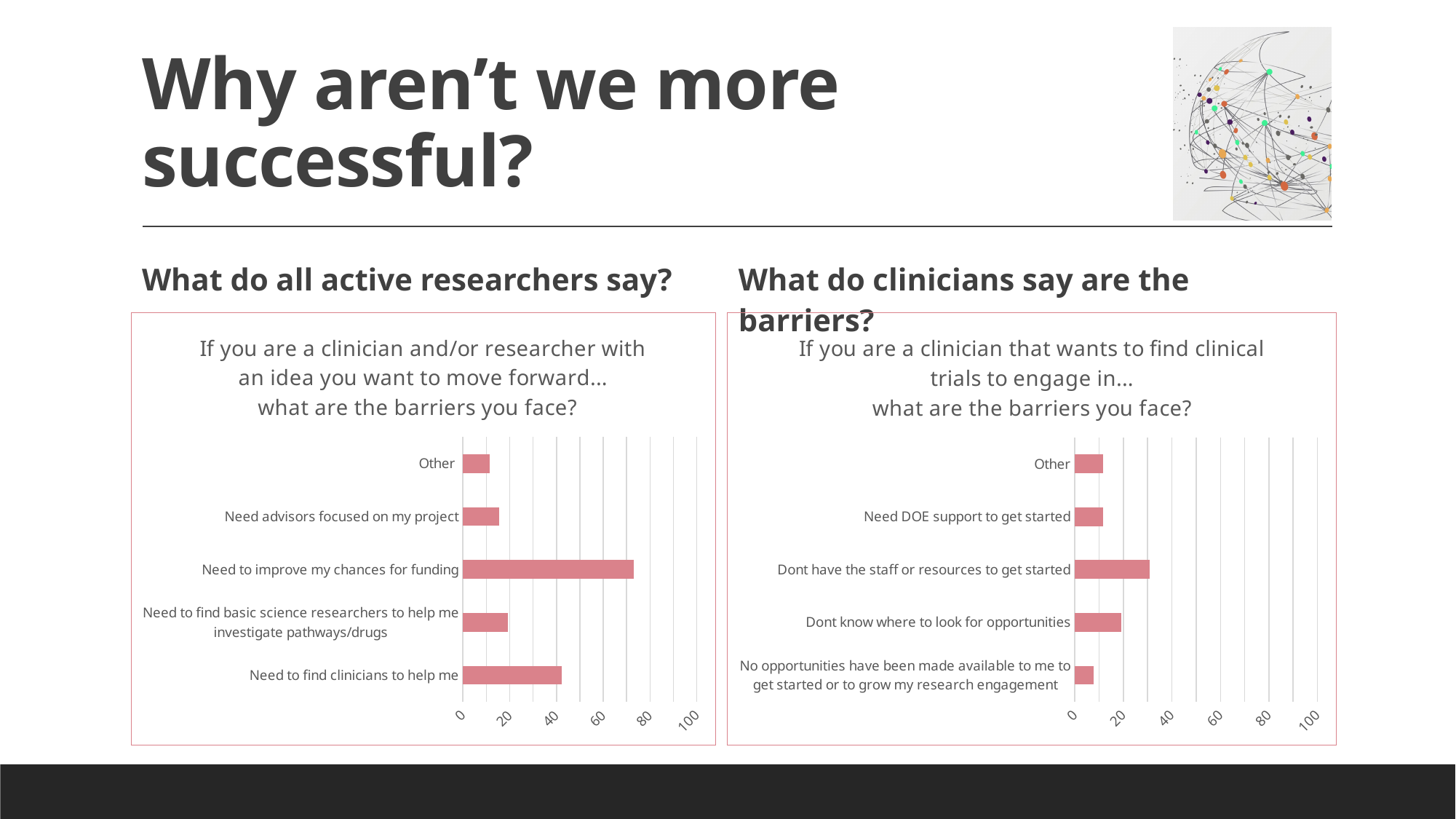
What kind of chart is the left chart, 'If you are a clinician and/or researcher with an idea you want to move forward... what are the barriers you face?'? Bar chart In the right chart (clinician that wants to find clinical trials), which barrier has the highest value? Dont have the staff or resources to get started In the right chart (clinician that wants to find clinical trials), is the value for 'Other' greater or less than 20? less What is the heading above the right chart? What do clinicians say are the barriers? In the left chart (clinician and/or researcher with an idea), is the value for 'Need to improve my chances for funding' greater or less than 60? greater How many categories are shown in the left chart (clinician and/or researcher with an idea)? 5 How many categories are shown in the right chart (clinician that wants to find clinical trials)? 5 In the left chart (clinician and/or researcher with an idea), which barrier has the highest value? Need to improve my chances for funding In the left chart (clinician and/or researcher with an idea), is the value for 'Need to find clinicians to help me' greater or less than 20? greater In the right chart (clinician that wants to find clinical trials), which is larger: 'Dont know where to look for opportunities' or 'Need DOE support to get started'? Dont know where to look for opportunities In the left chart (clinician and/or researcher with an idea), which is larger: 'Need to find clinicians to help me' or 'Need advisors focused on my project'? Need to find clinicians to help me